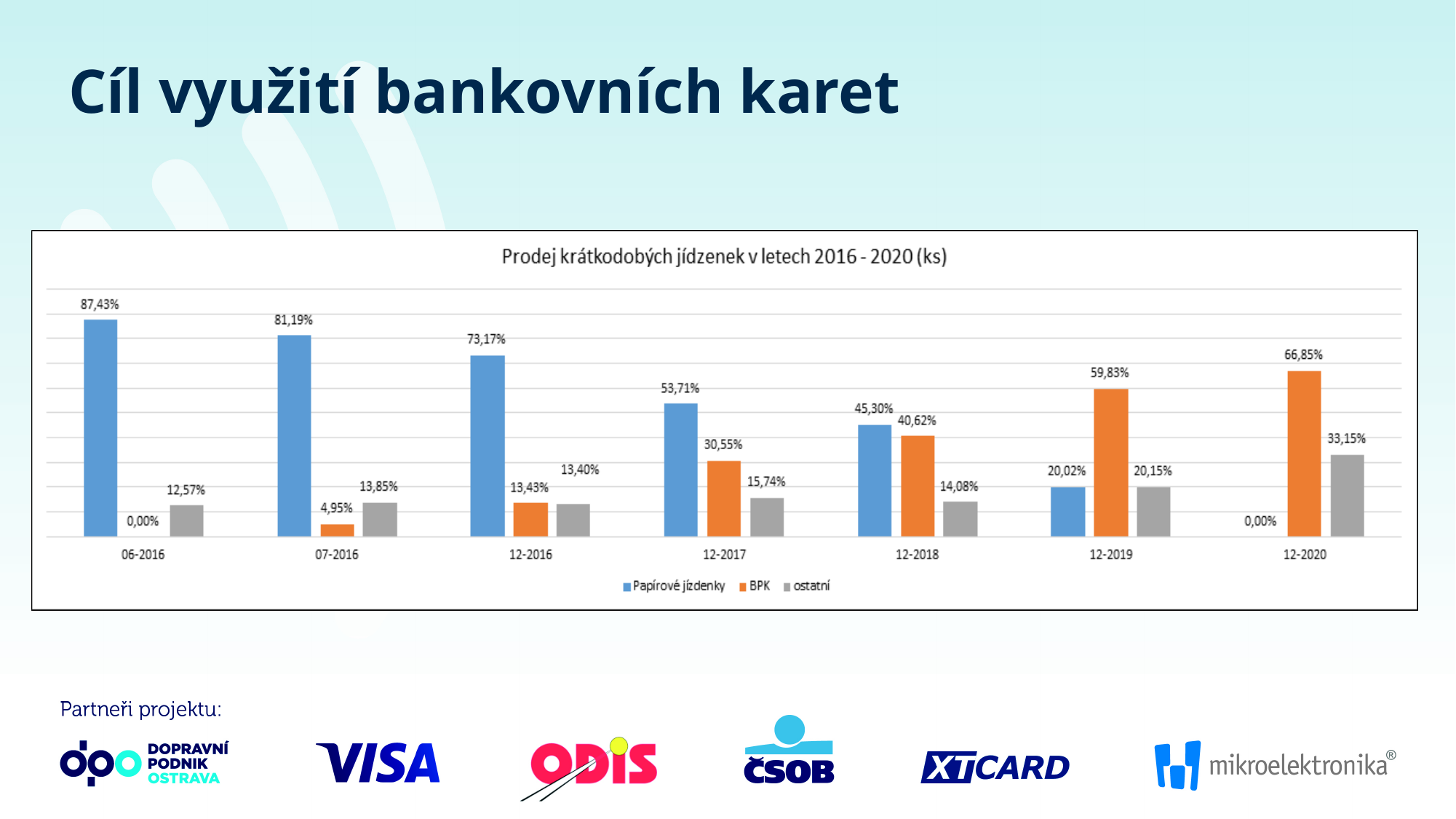
What is the difference between the BPK values in 12-2020 and 12-2019? 7,02% What is the value for ostatní in 12-2020? 33,15% In which period is the BPK value highest? 12-2020 Which is larger in 12-2019: Papírové jízdenky or BPK? BPK What is the value for BPK in 07-2016? 4,95% What is the value for BPK in 12-2018? 40,62% How many series does the legend list? 3 What is the value for Papírové jízdenky in 06-2016? 87,43% In which period is the Papírové jízdenky value lowest? 12-2020 How many periods are shown on the x axis? 7 What is the difference between the Papírové jízdenky values in 06-2016 and 12-2016? 14,26% Does the Papírové jízdenky series rise or fall from 06-2016 to 12-2020? fall